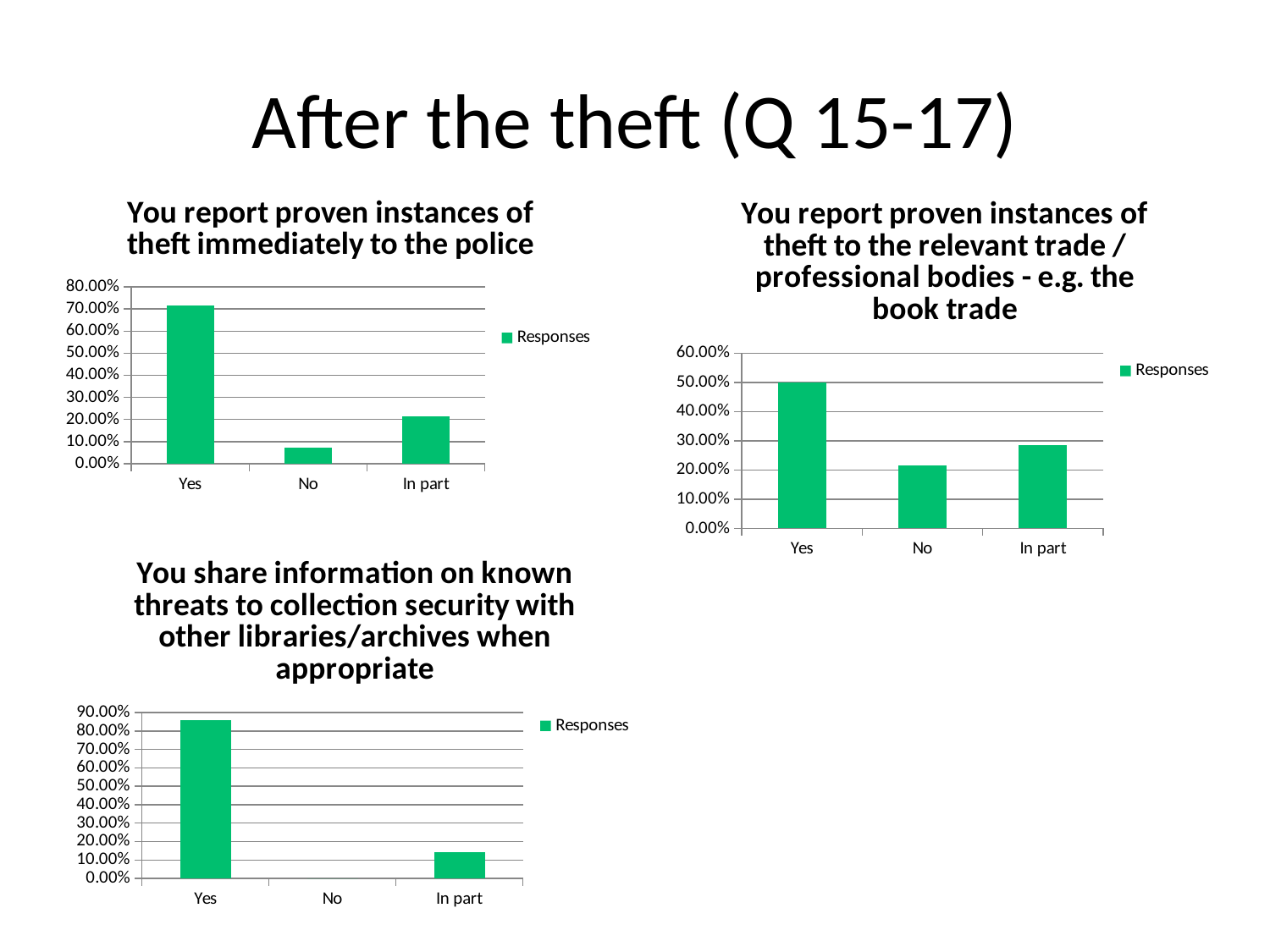
In the chart titled 'You report proven instances of theft to the relevant trade / professional bodies - e.g. the book trade', what is the value for Yes? 50.00% In the chart titled 'You report proven instances of theft to the relevant trade / professional bodies - e.g. the book trade', which is larger, No or In part? In part What type of chart is the chart titled 'You report proven instances of theft immediately to the police'? Bar chart In the chart titled 'You report proven instances of theft immediately to the police', which category has the highest value? Yes In the chart titled 'You report proven instances of theft immediately to the police', which category has the lowest value? No How many categories are shown on the x axis of the chart titled 'You share information on known threats to collection security with other libraries/archives when appropriate'? 3 In the chart titled 'You report proven instances of theft immediately to the police', is the value for No greater or less than 10.00%? less In the chart titled 'You report proven instances of theft immediately to the police', is the value for Yes greater or less than 60.00%? greater In the chart titled 'You share information on known threats to collection security with other libraries/archives when appropriate', what is the value for No? 0.00% How many series does the legend list in the chart titled 'You report proven instances of theft to the relevant trade / professional bodies - e.g. the book trade'? 1 In the chart titled 'You share information on known threats to collection security with other libraries/archives when appropriate', is the value for Yes greater or less than 80.00%? greater